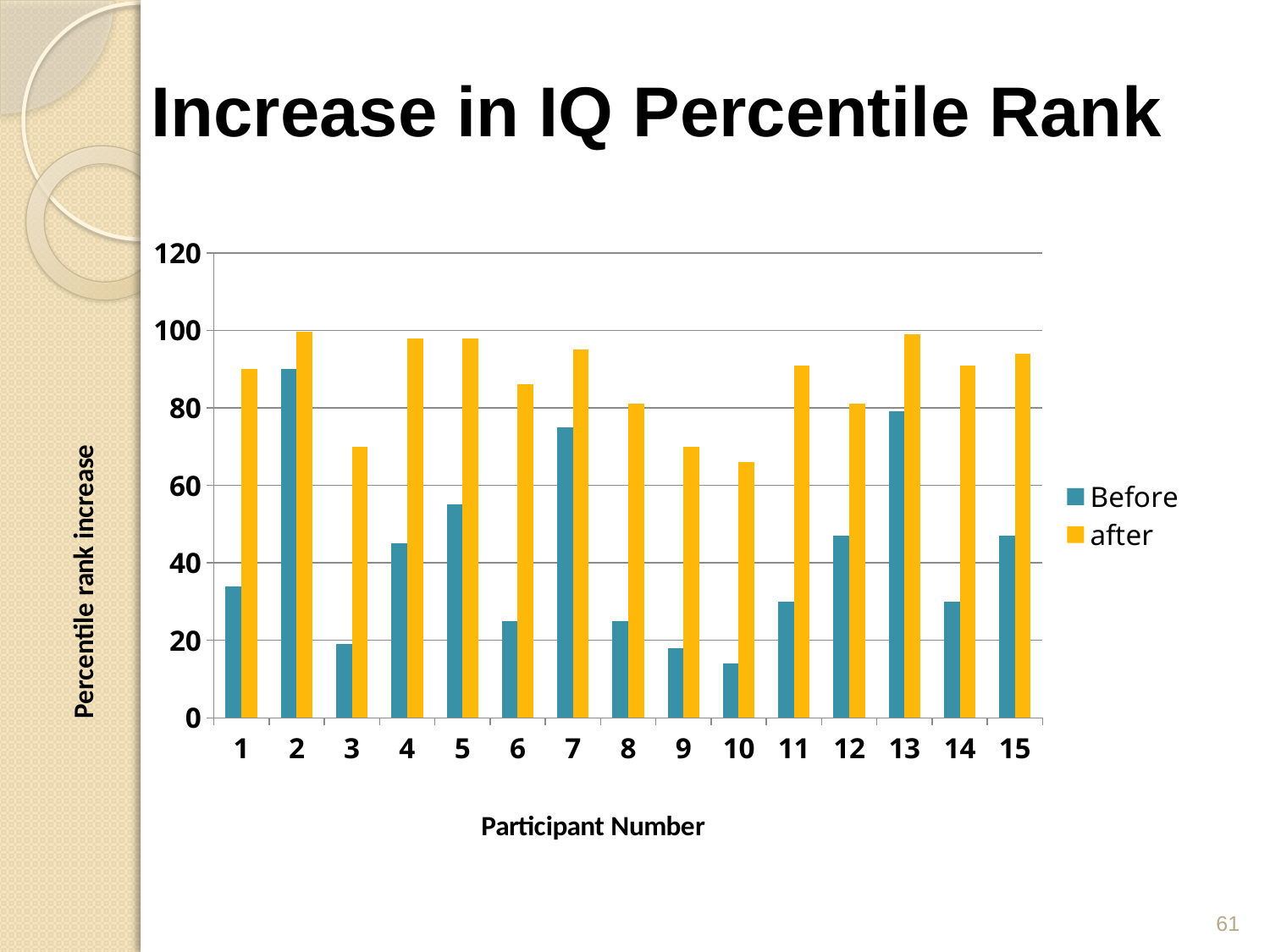
Is the after value for participant 3 greater or less than 80? less What is the label on the x axis of the chart? Participant Number Is the Before value for participant 7 greater or less than 60? greater Which is larger, the after value for participant 1 or the after value for participant 10? Participant 1 Which participant has the highest Before value? 2 What is the title of the slide's chart? Increase in IQ Percentile Rank Is the Before value for participant 2 greater or less than 80? greater Which is larger, the Before value for participant 7 or the Before value for participant 5? Participant 7 How many participants are shown on the x axis of the chart? 15 What kind of chart is shown on the slide? Bar chart How many series does the chart's legend list? 2